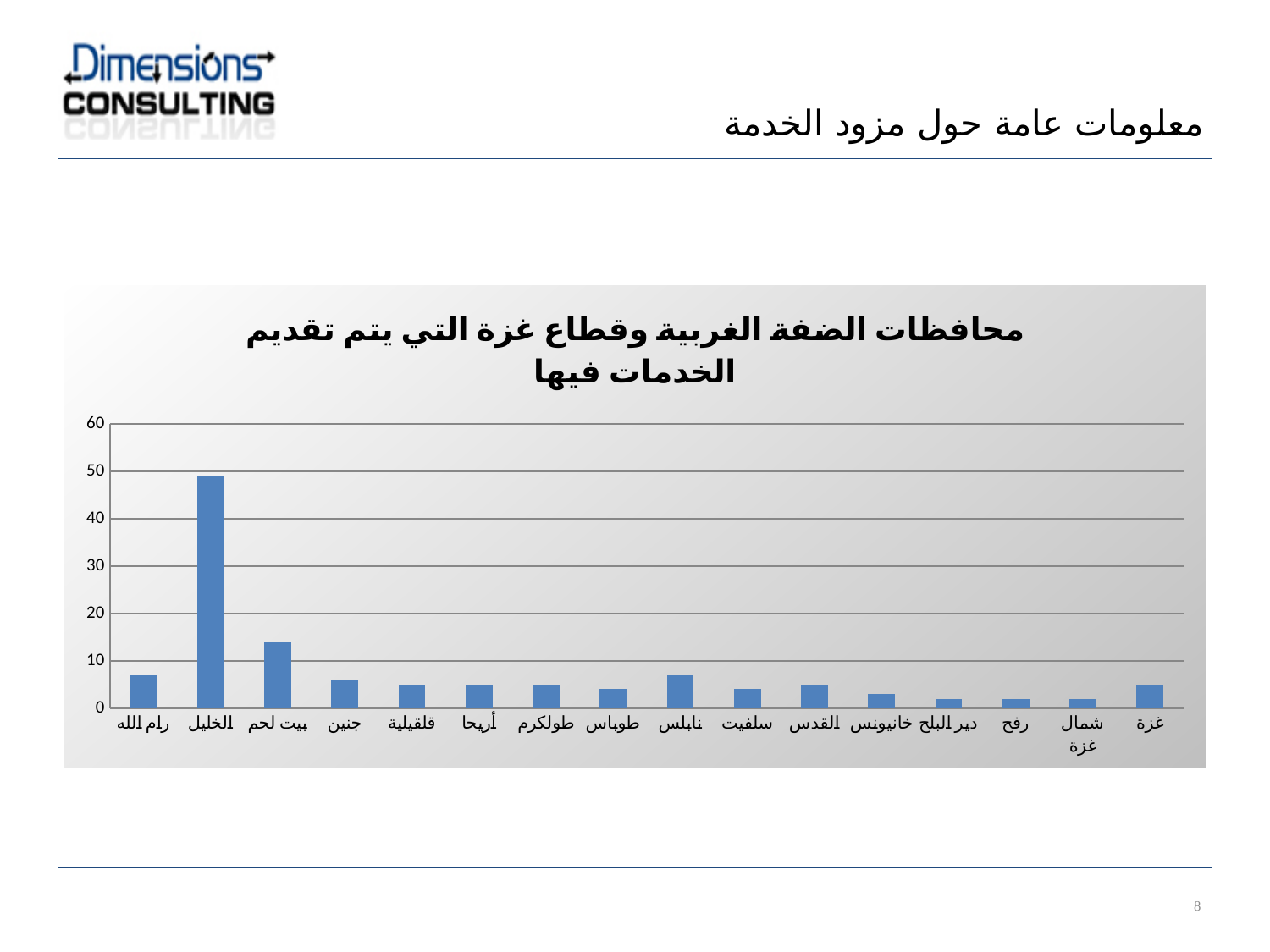
Which is larger, the value for بيت لحم or the value for جنين? بيت لحم Is the value for بيت لحم greater or less than 10? greater What is the title of the chart? محافظات الضفة الغربية وقطاع غزة التي يتم تقديم الخدمات فيها What is the highest value shown on the chart's vertical axis? 60 Which is larger, the value for الخليل or the value for بيت لحم? الخليل Is the value for الخليل greater or less than 40? greater What kind of chart is shown on the slide? bar chart Is the value for غزة greater or less than 10? less Which governorate has the highest bar in the chart? الخليل How many governorates (categories) are shown on the x axis of the chart? 16